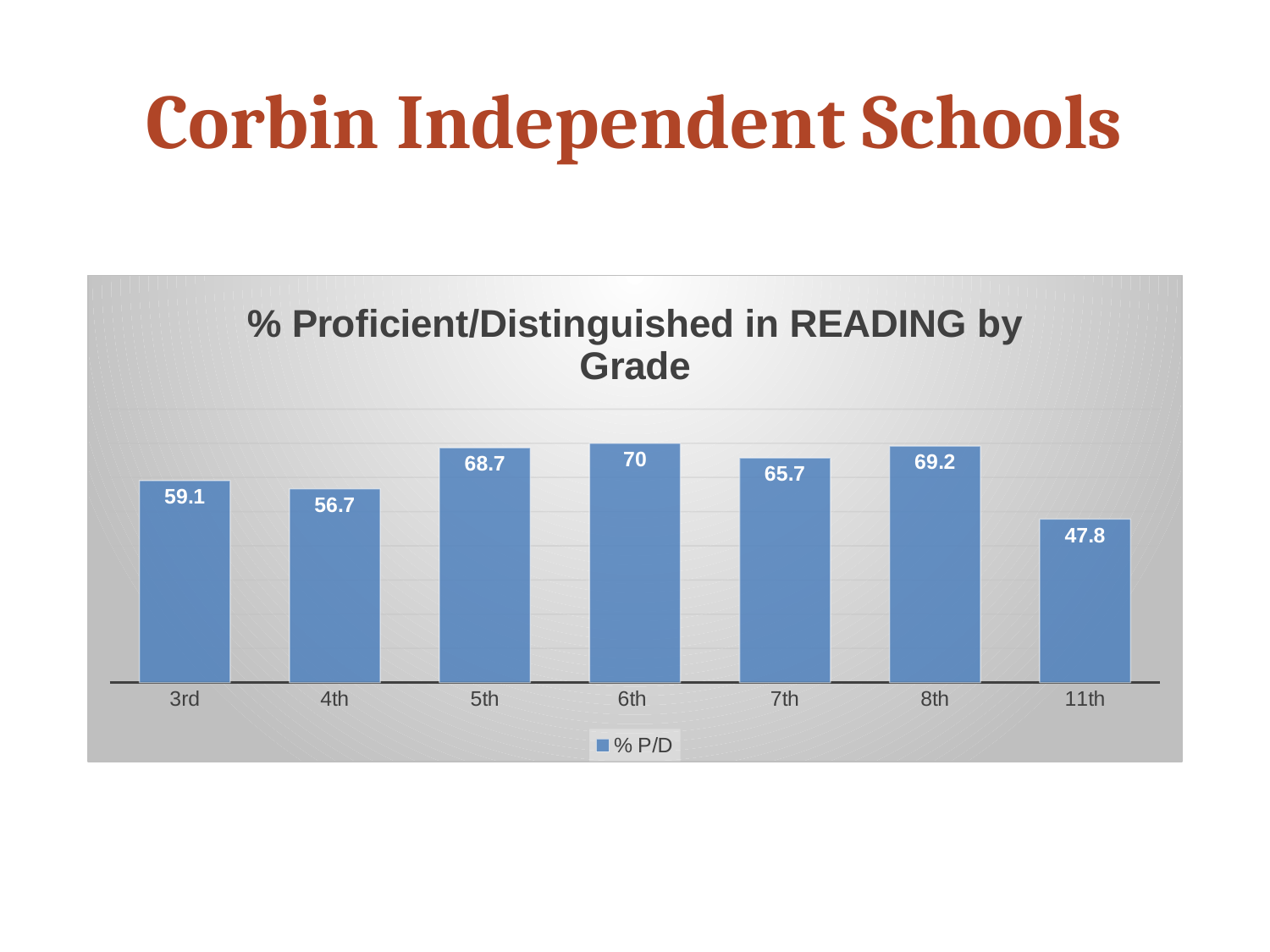
Which grade has the highest % Proficient/Distinguished in reading? 6th What is the difference between the % P/D values for 3rd grade and 4th grade? 2.4 What kind of chart is shown on the slide? Bar chart Which has a higher % P/D value, 7th grade or 8th grade? 8th What is the % P/D value for 5th grade? 68.7 What is the title of the chart? % Proficient/Distinguished in READING by Grade Which grade has the lowest % Proficient/Distinguished in reading? 11th How many series does the legend list? 1 What is the % P/D value for 11th grade? 47.8 What is the % P/D value for 3rd grade? 59.1 How many grades are shown on the chart? 7 What is the difference between the % P/D values for 6th grade and 11th grade? 22.2